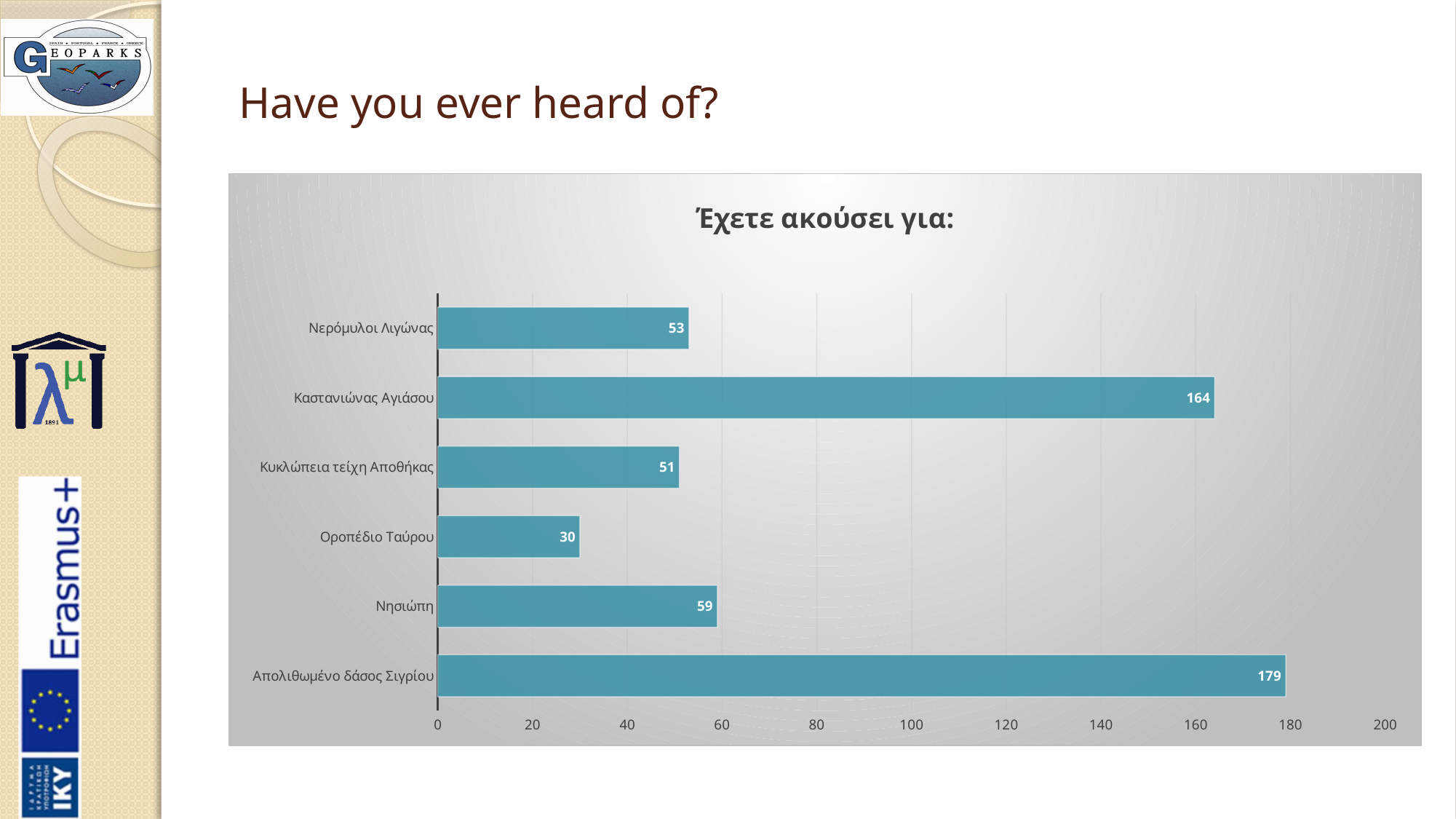
What is the value for Οροπέδιο Ταύρου? 30 What is the value for Νησιώπη? 59 What is the title of the chart? Έχετε ακούσει για: Which is larger, the value for Νερόμυλοι Λιγώνας or the value for Νησιώπη? Νησιώπη Which category has the lowest value? Οροπέδιο Ταύρου What is the value for Απολιθωμένο δάσος Σιγρίου? 179 How many categories are shown in the chart? 6 Which category has the highest value? Απολιθωμένο δάσος Σιγρίου What is the difference between the values for Απολιθωμένο δάσος Σιγρίου and Καστανιώνας Αγιάσου? 15 Is the value for Κυκλώπεια τείχη Αποθήκας greater or less than 60? less What is the value for Καστανιώνας Αγιάσου? 164 What kind of chart is shown on the slide? bar chart